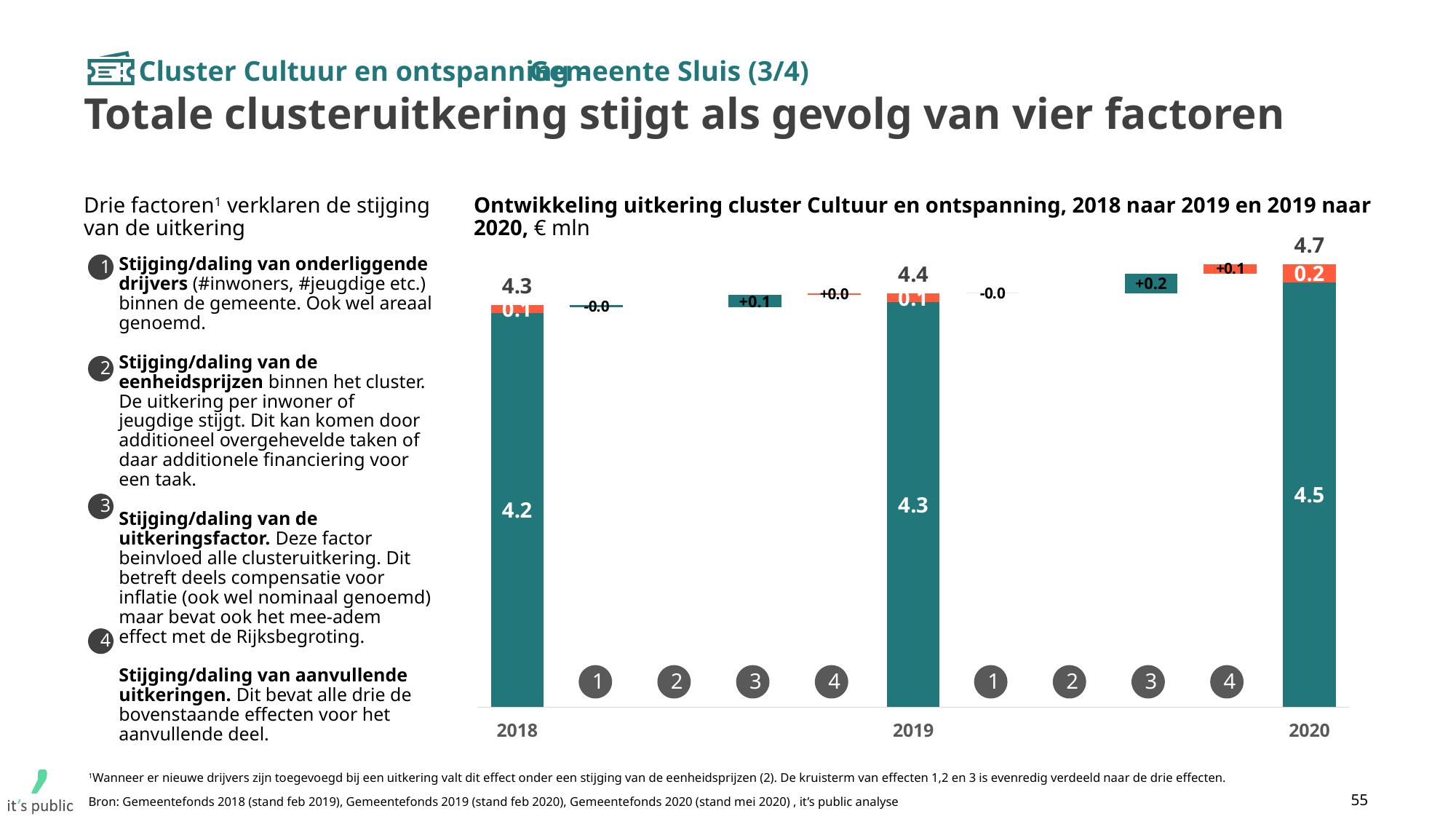
What is the total uitkering shown for 2018? 4.3 Which year has the lowest total uitkering? 2018 In what unit are the values in the chart expressed? € mln What is the value of the teal segment of the 2019 bar? 4.3 What is the total uitkering shown for 2020? 4.7 What is the value of the teal (lower) segment of the 2020 bar? 4.5 What is the value of the orange (upper) segment of the 2020 bar? 0.2 What is the difference between the 2020 total and the 2018 total? 0.4 Which year has the highest total uitkering? 2020 Do the total values rise or fall from 2018 to 2020? rise What is the change attributed to factor 4 between 2019 and 2020? +0.1 What is the change attributed to factor 3 between 2019 and 2020? +0.2